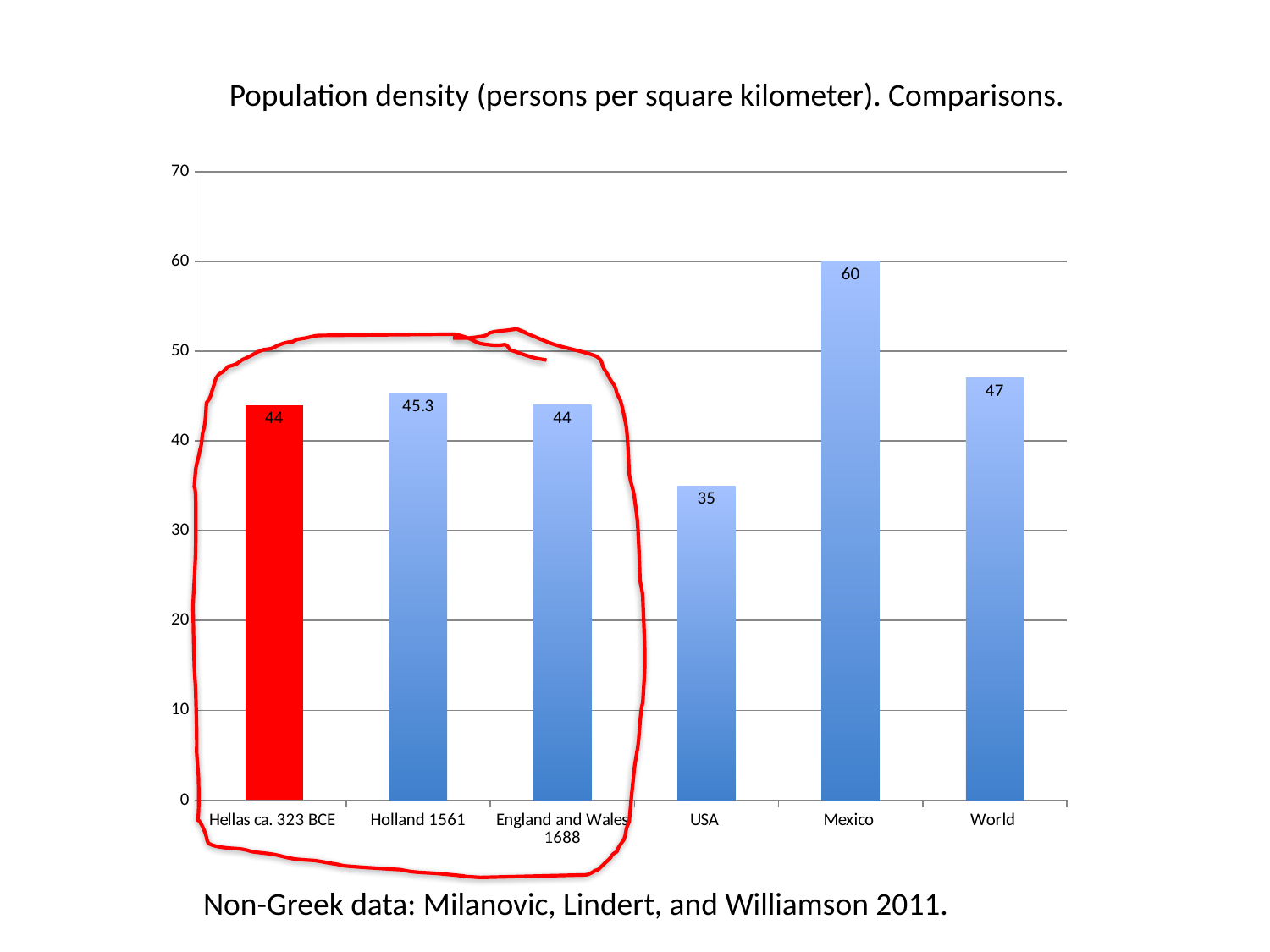
Which is larger, the value for World or the value for England and Wales 1688? World How many categories are shown on the x axis? 6 Is the value for Holland 1561 greater or less than 50? less Which category has the lowest population density? USA What is the value shown for Holland 1561? 45.3 What kind of chart is shown on the slide? bar chart What is the difference between the values for Mexico and World? 13 What is the value shown for Mexico? 60 What is the population density value for Hellas ca. 323 BCE? 44 What is the value shown for the USA? 35 Which category has the highest population density? Mexico Which bar is coloured red rather than blue? Hellas ca. 323 BCE